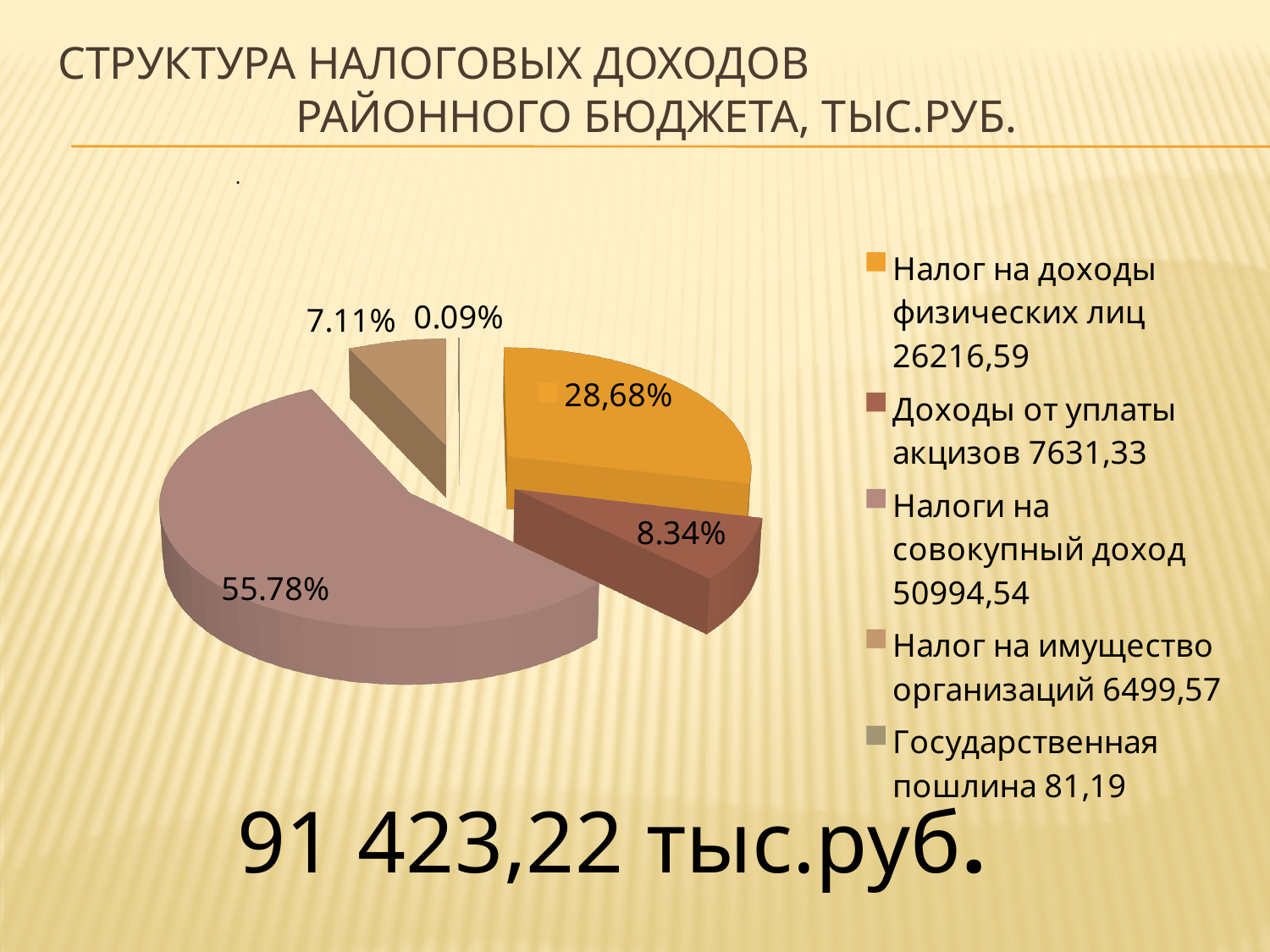
What value is shown in the legend for 'Налог на доходы физических лиц'? 26216,59 What share of the pie does 'Налог на доходы физических лиц' take? 28,68% How many entries does the legend list? 5 What kind of chart is shown on the slide? pie chart What share of the pie does 'Доходы от уплаты акцизов' take? 8.34% What share of the pie does 'Государственная пошлина' take? 0.09% Which category has the smallest slice of the pie? Государственная пошлина Which category has the largest slice of the pie? Налоги на совокупный доход Which is larger: the slice for 'Доходы от уплаты акцизов' or the slice for 'Налог на имущество организаций'? Доходы от уплаты акцизов How many slices does the pie chart have? 5